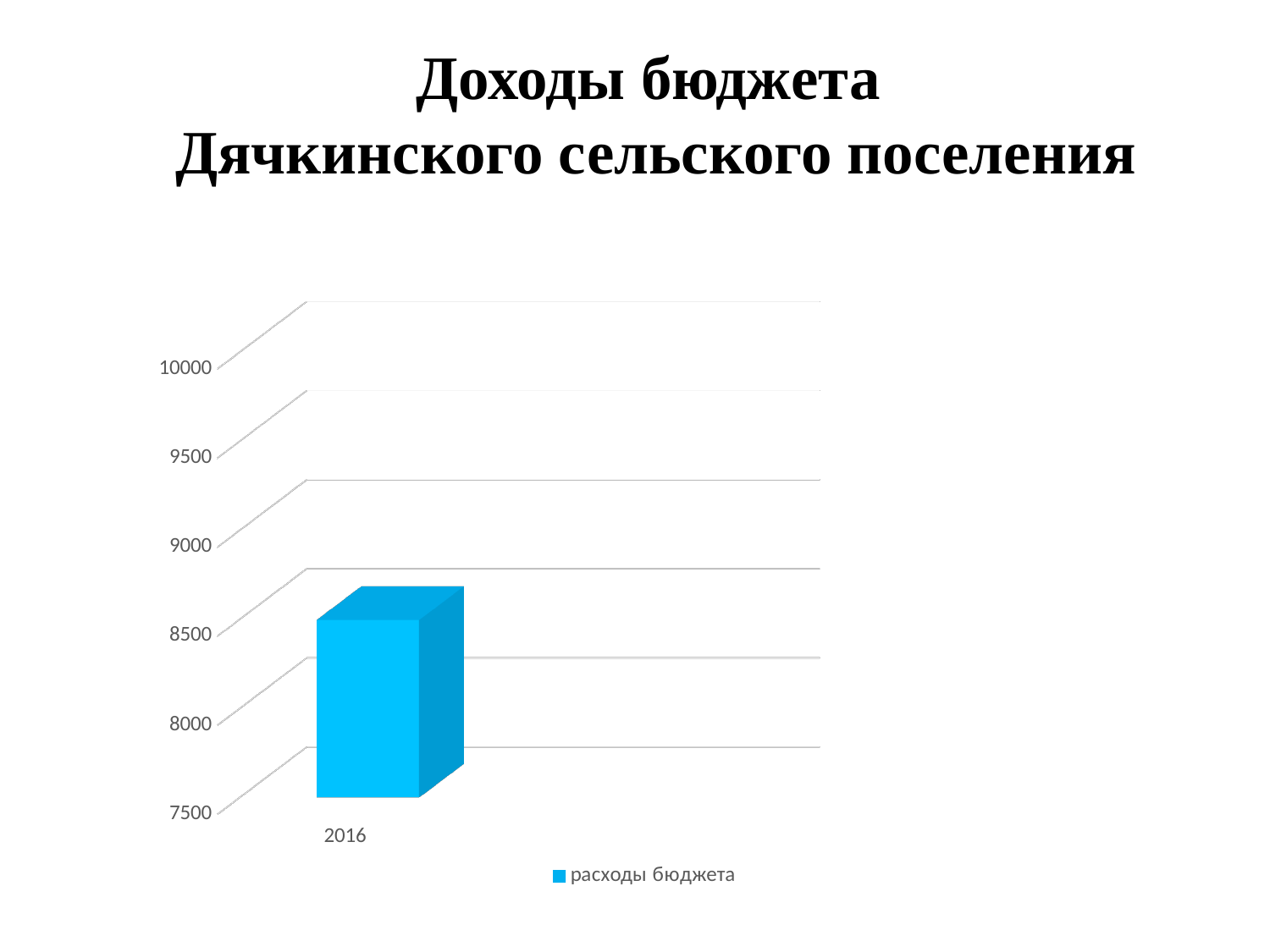
What is the title of the slide above the chart? Доходы бюджета Дячкинского сельского поселения What is the lowest value shown on the vertical axis? 7500 Is the value for 2016 greater or less than 8000? greater How many bars are plotted in the chart? 1 How many series does the legend list? 1 Which year is shown on the x axis of the chart? 2016 Is the value for 2016 greater or less than 9000? less Is the value for 2016 greater or less than 10000? less What is the series name shown in the legend? расходы бюджета What kind of chart is shown on the slide? bar chart